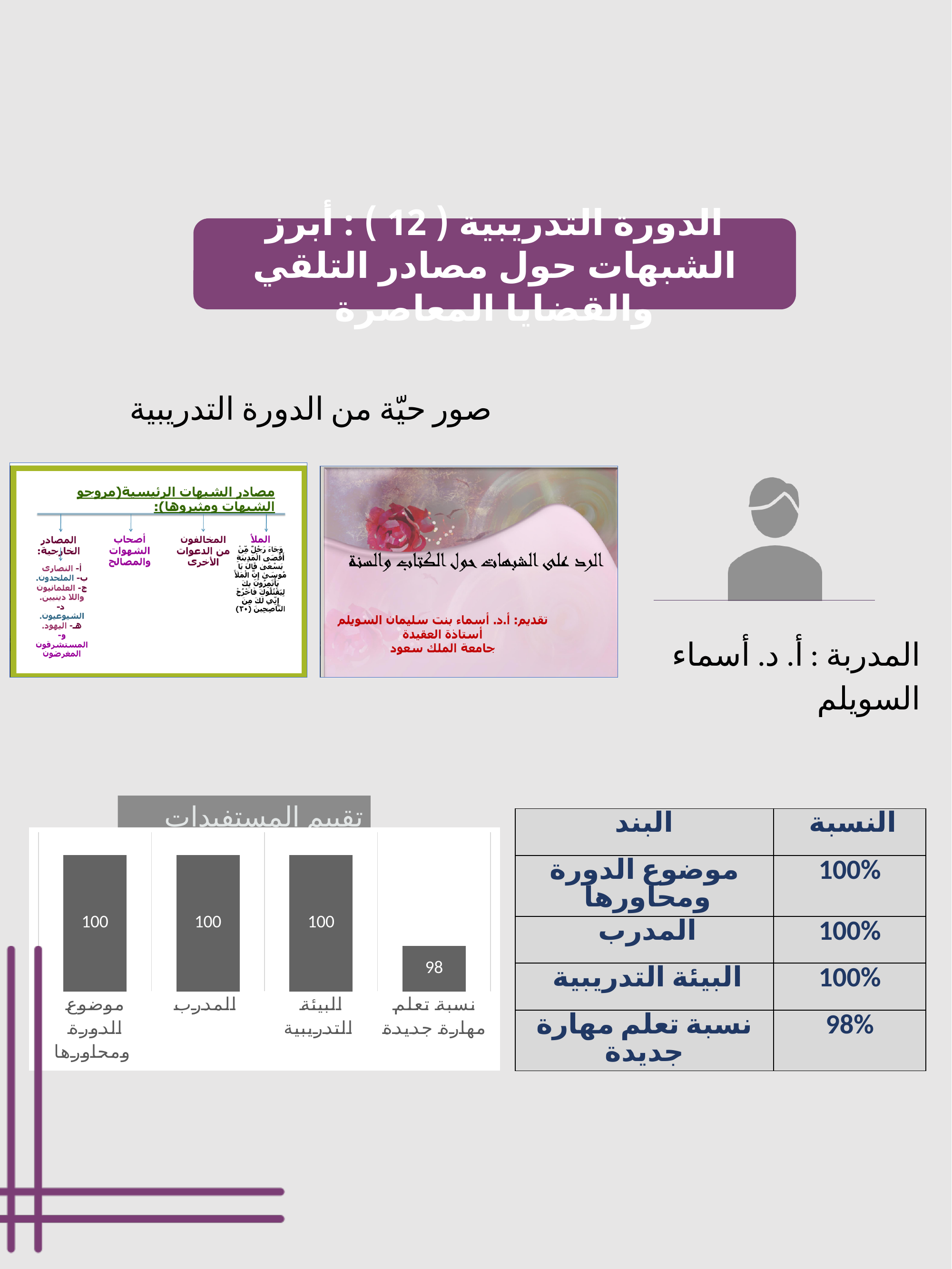
What is the value for نسبة تعلم مهارة جديدة in the chart? 98 How many categories in the chart have a value of 100? 3 What is the value for البيئة التدريبية in the chart? 100 What colour are the bars in the chart? grey How many categories are shown in the chart? 4 Which is larger in the chart: the value for البيئة التدريبية or the value for نسبة تعلم مهارة جديدة? البيئة التدريبية What is the value for المدرب in the chart? 100 What is the value for موضوع الدورة ومحاورها in the chart? 100 What is the difference between the value for المدرب and the value for نسبة تعلم مهارة جديدة? 2 Which category has the lowest value in the chart? نسبة تعلم مهارة جديدة What is the title of the chart on the slide? تقييم المستفيدات What type of chart is shown on the slide? bar chart